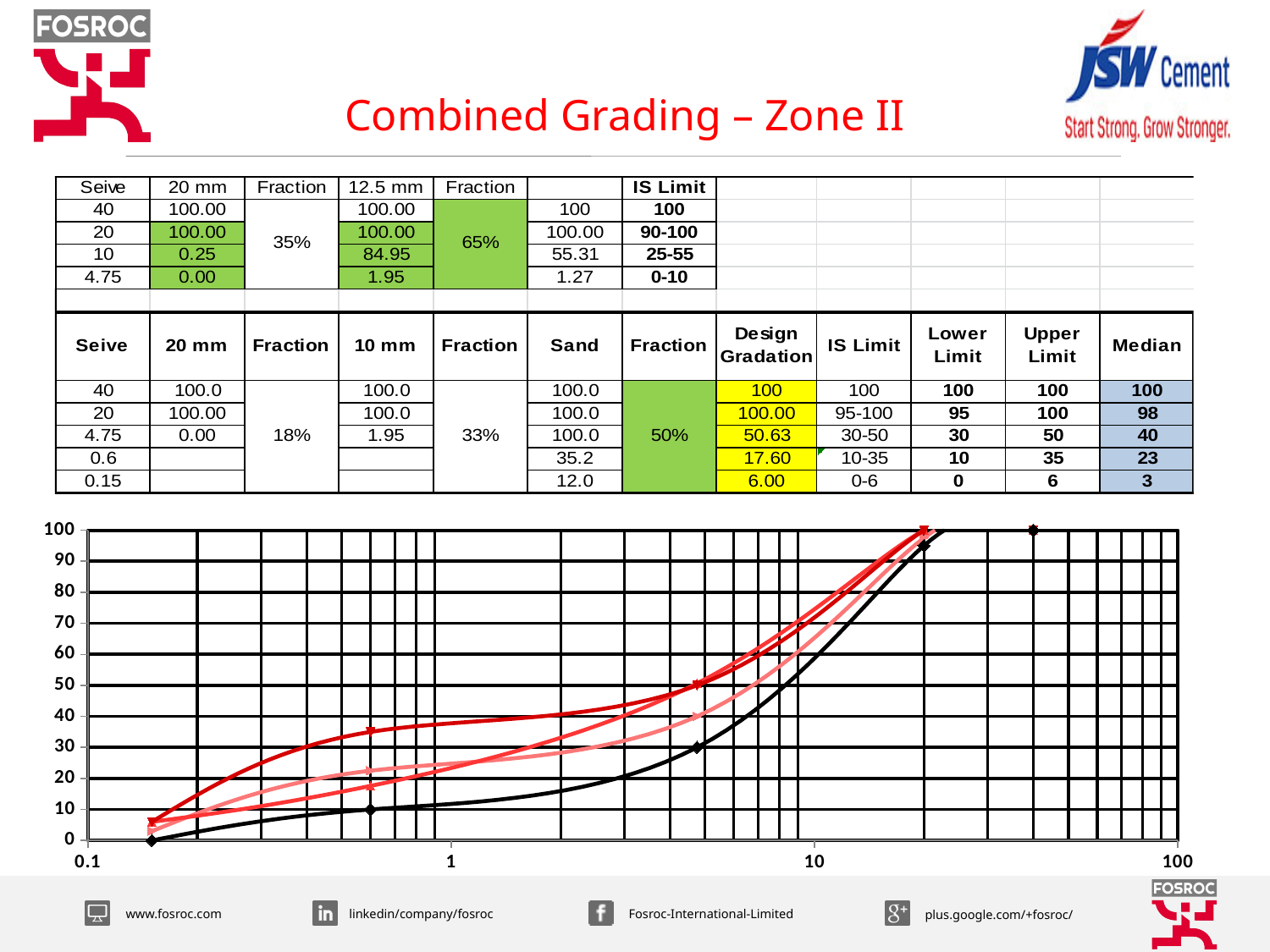
Which line lies lowest on the chart across the plotted range? the black line What kind of chart is shown at the bottom of the slide? line chart Do the plotted lines rise or fall as you move from left to right along the x axis? rise How many lines are plotted on the chart? 4 What is the highest value labelled on the y axis? 100 What are the labelled tick values on the x axis? 0.1, 1, 10, 100 What is the value of the black line at its leftmost marker? 0 Is the value of the black line at x = 1 greater or less than 20? less Is the value of the black line at x = 10 greater or less than 50? greater Is the value of the topmost (dark red) line at x = 1 greater or less than 30? greater